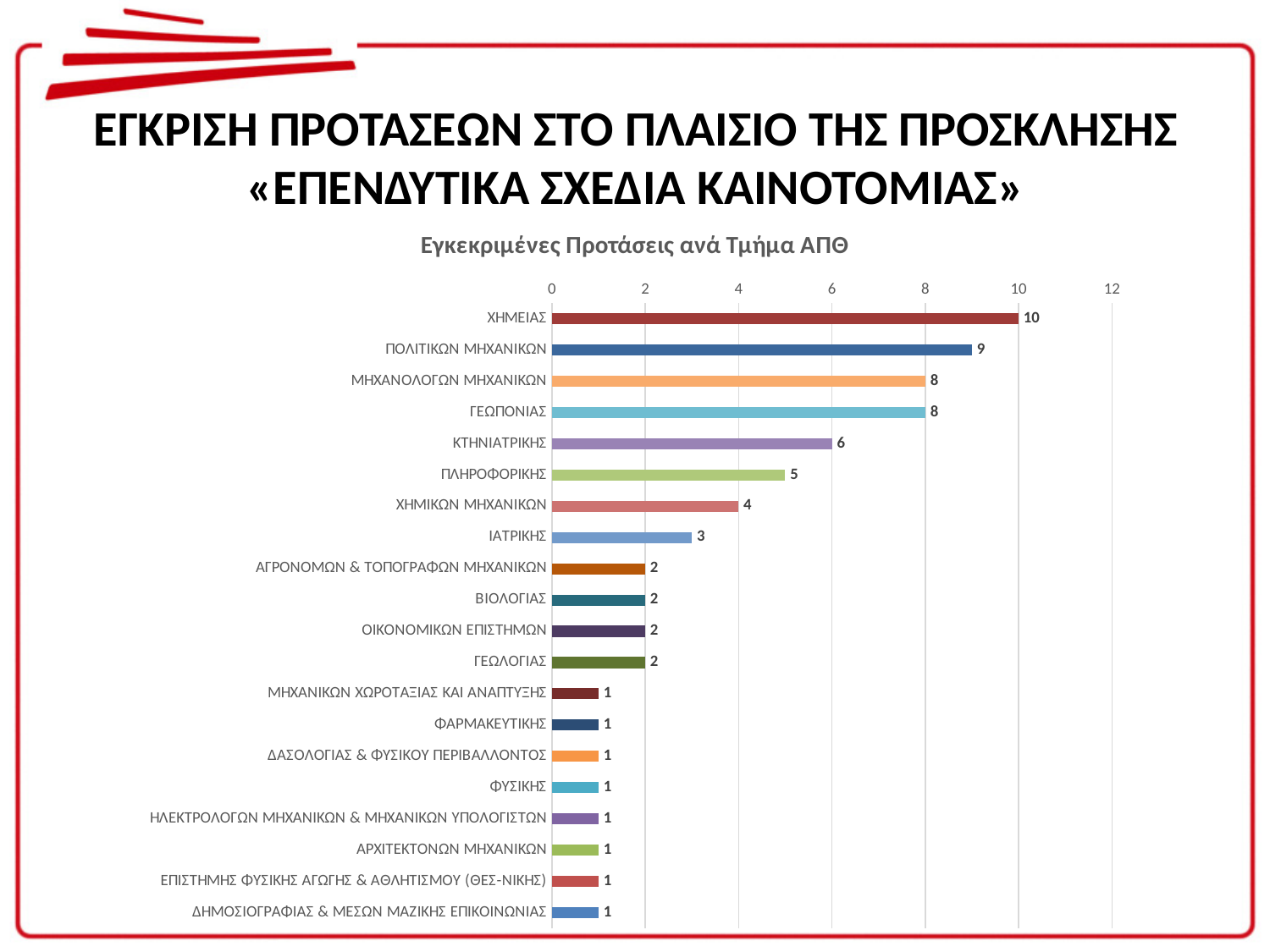
What value is shown for ΧΗΜΕΙΑΣ? 10 What value is shown for ΠΛΗΡΟΦΟΡΙΚΗΣ? 5 What is the difference between the values for ΧΗΜΕΙΑΣ and ΠΟΛΙΤΙΚΩΝ ΜΗΧΑΝΙΚΩΝ? 1 Which department has the highest value? ΧΗΜΕΙΑΣ What kind of chart is shown on the slide? bar chart What value is shown for ΙΑΤΡΙΚΗΣ? 3 Which is larger, the value for ΚΤΗΝΙΑΤΡΙΚΗΣ or the value for ΙΑΤΡΙΚΗΣ? ΚΤΗΝΙΑΤΡΙΚΗΣ Is the value for ΠΟΛΙΤΙΚΩΝ ΜΗΧΑΝΙΚΩΝ greater or less than 6? greater What value is shown for ΚΤΗΝΙΑΤΡΙΚΗΣ? 6 What is the title of the chart? Εγκεκριμένες Προτάσεις ανά Τμήμα ΑΠΘ What is the difference between the values for ΓΕΩΠΟΝΙΑΣ and ΧΗΜΙΚΩΝ ΜΗΧΑΝΙΚΩΝ? 4 How many departments are shown in the chart? 20